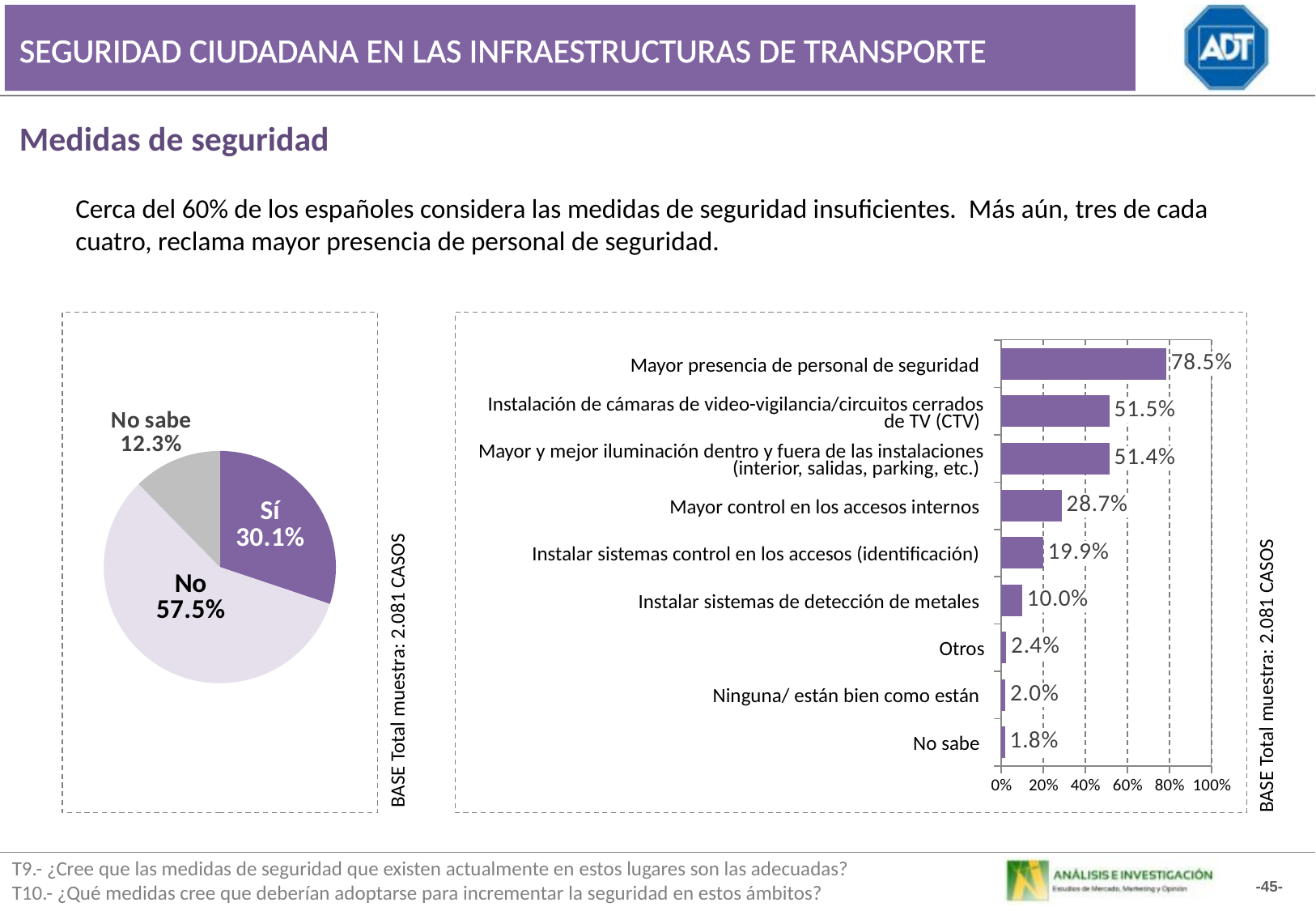
In the bar chart on the right, how many categories are shown? 9 What type of chart is shown on the right side of the slide? Bar chart In the bar chart on the right, what is the difference between "Mayor presencia de personal de seguridad" and "Instalación de cámaras de video-vigilancia/circuitos cerrados de TV (CTV)"? 27.0% In the pie chart on the left, what share is labelled "No"? 57.5% In the pie chart on the left, how many slices are there? 3 In the bar chart on the right, which is larger: "Instalar sistemas control en los accesos (identificación)" or "Instalar sistemas de detección de metales"? Instalar sistemas control en los accesos (identificación) In the bar chart on the right, what is the value for "Mayor presencia de personal de seguridad"? 78.5% In the bar chart on the right, which category has the highest value? Mayor presencia de personal de seguridad In the pie chart on the left, what share is labelled "Sí"? 30.1% In the pie chart on the left, which slice is the smallest? No sabe In the bar chart on the right, what is the value for "Mayor control en los accesos internos"? 28.7% In the bar chart on the right, which category has the lowest value? No sabe